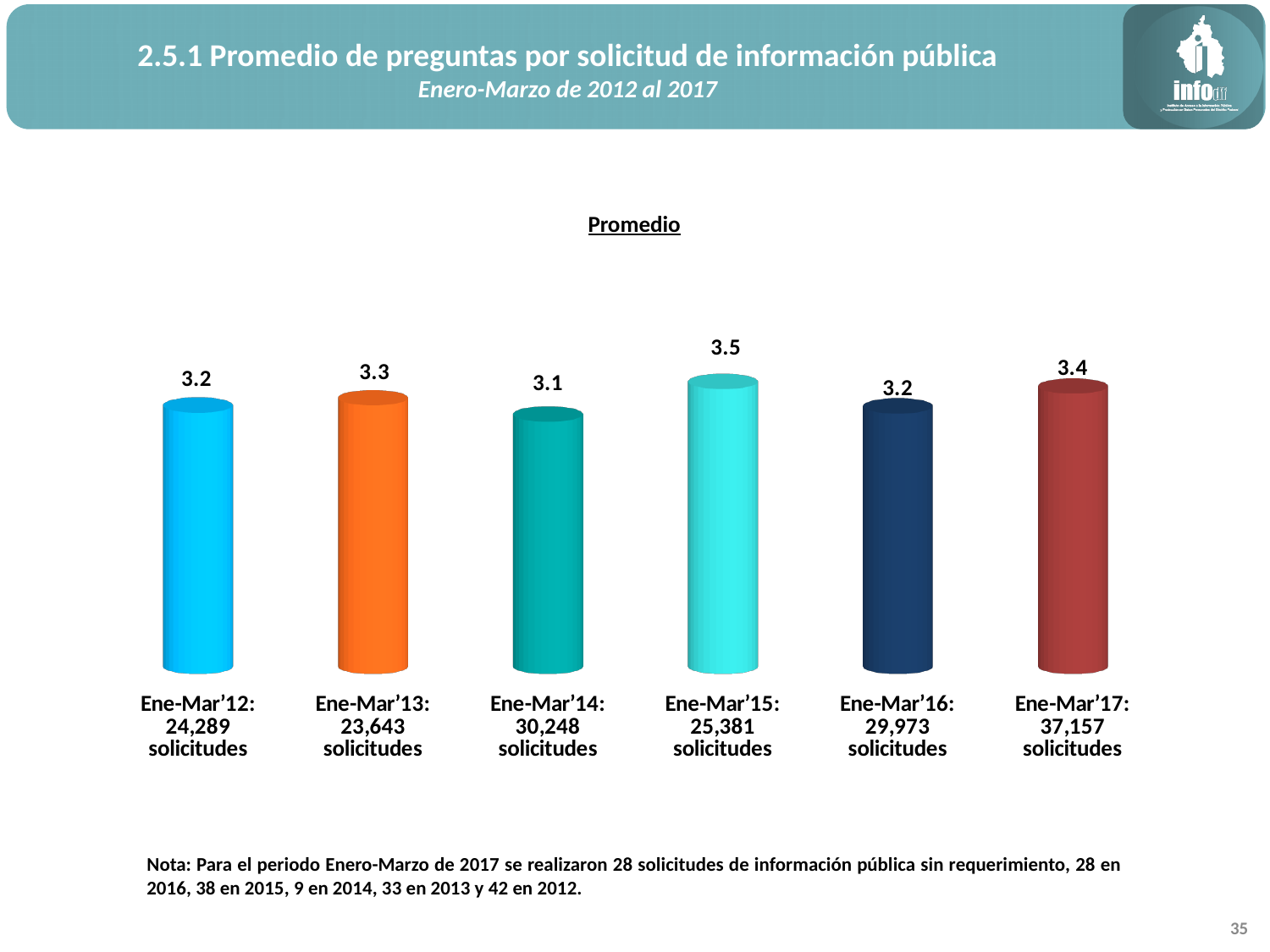
What is the value shown for Ene-Mar'17? 3.4 What is the average number of questions per request for Ene-Mar'15? 3.5 What is the difference between the values for Ene-Mar'15 and Ene-Mar'14? 0.4 Which period has the highest average? Ene-Mar'15 How many solicitudes are listed under the Ene-Mar'17 label? 37,157 What is the value shown for Ene-Mar'14? 3.1 What is the difference between the values for Ene-Mar'17 and Ene-Mar'16? 0.2 Which period has the lowest average? Ene-Mar'14 Which is larger, the value for Ene-Mar'13 or the value for Ene-Mar'16? Ene-Mar'13 What kind of chart is shown on the slide? bar chart How many periods are shown in the chart? 6 What is the title shown above the chart? Promedio